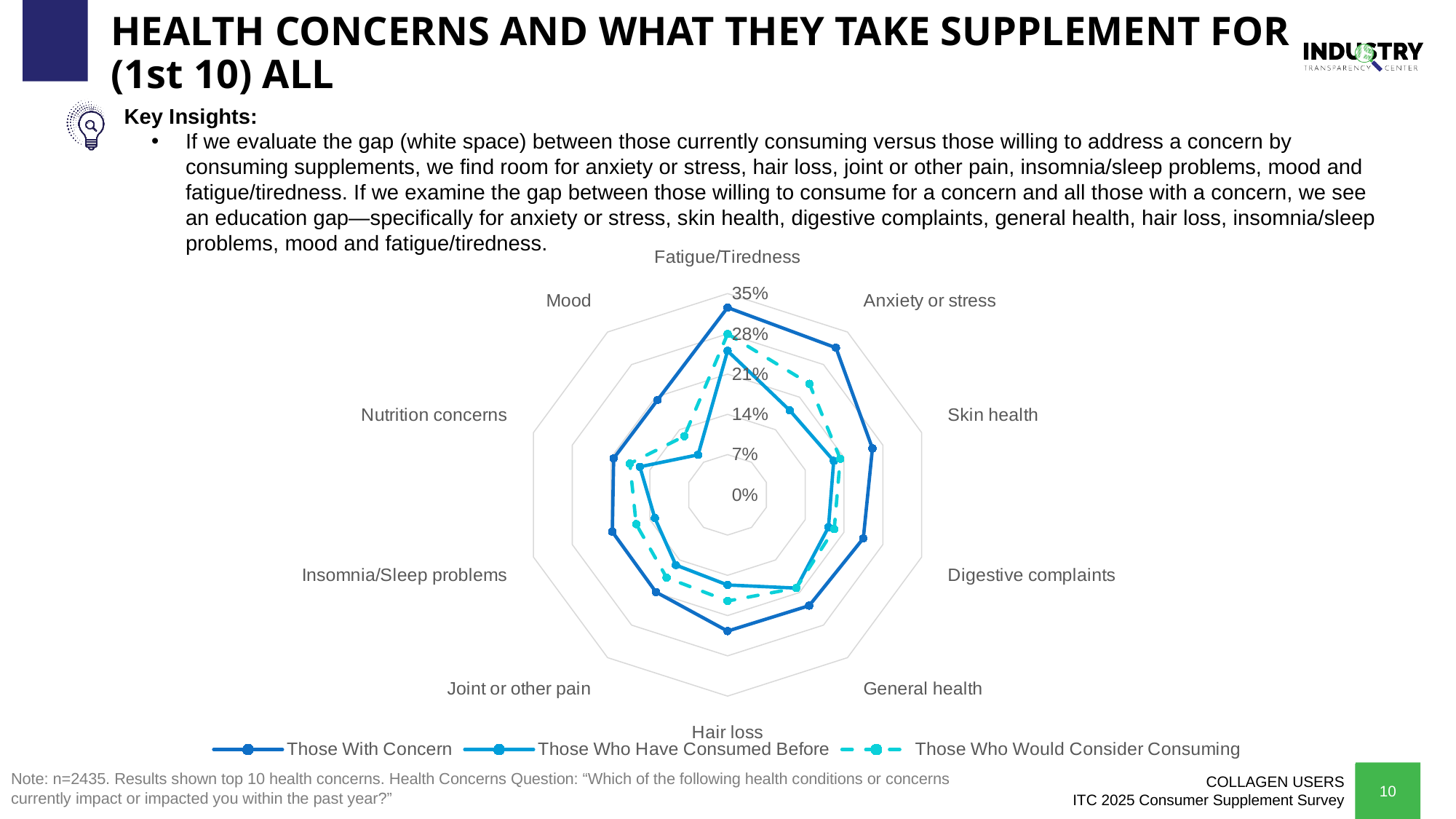
Is the 'Those With Concern' value for Fatigue/Tiredness greater or less than 28%? greater What is the highest percentage tick shown on the radar chart's axis? 35% For Fatigue/Tiredness, which series has the larger value: 'Those With Concern' or 'Those Who Have Consumed Before'? Those With Concern Is the 'Those Who Have Consumed Before' value for Fatigue/Tiredness greater or less than 21%? greater Which category has the lowest value for the 'Those Who Have Consumed Before' series? Mood Which series in the legend is drawn with a dashed line? Those Who Would Consider Consuming Is the 'Those Who Have Consumed Before' value for Nutrition concerns greater or less than 14%? greater How many series does the legend of the radar chart list? 3 How many health concern categories are plotted on the radar chart? 10 Which category has the highest value for the 'Those Who Have Consumed Before' series? Fatigue/Tiredness For Anxiety or stress, which series has the larger value: 'Those Who Would Consider Consuming' or 'Those Who Have Consumed Before'? Those Who Would Consider Consuming What kind of chart is shown on the slide? Radar chart